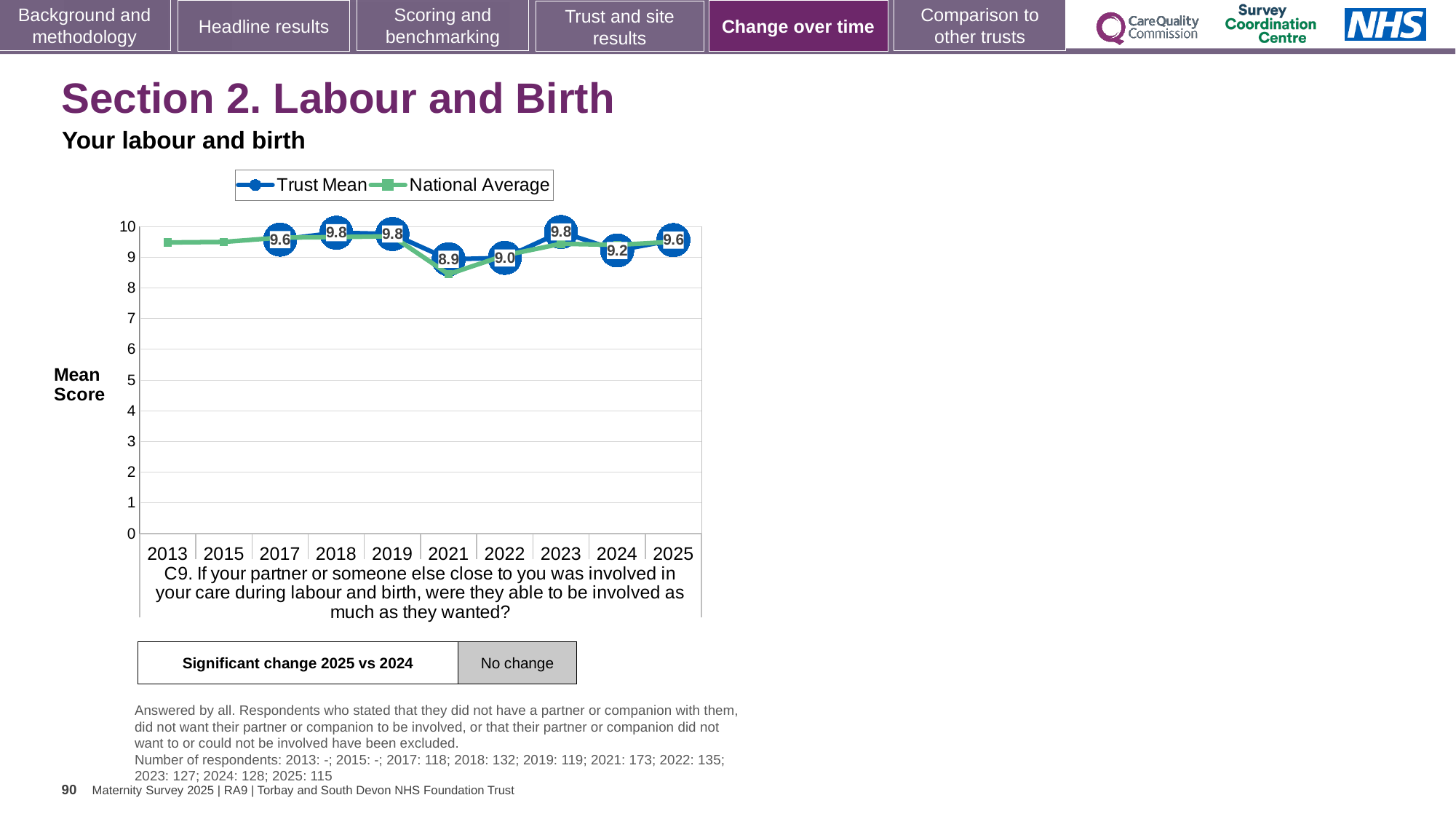
What kind of chart is shown on the slide? line chart What is the Trust Mean value for 2021? 8.9 Does the Trust Mean rise or fall from 2023 to 2024? fall Is the National Average value for 2021 greater or less than 9? less In which year is the Trust Mean lowest? 2021 What does the 'Significant change 2025 vs 2024' box say? No change What is the difference between the Trust Mean in 2025 and in 2024? 0.4 How many series does the legend list? 2 What is the Trust Mean value for 2025? 9.6 Which year has the larger Trust Mean, 2021 or 2022? 2022 How many years are shown on the x axis? 10 What is the Trust Mean value for 2024? 9.2